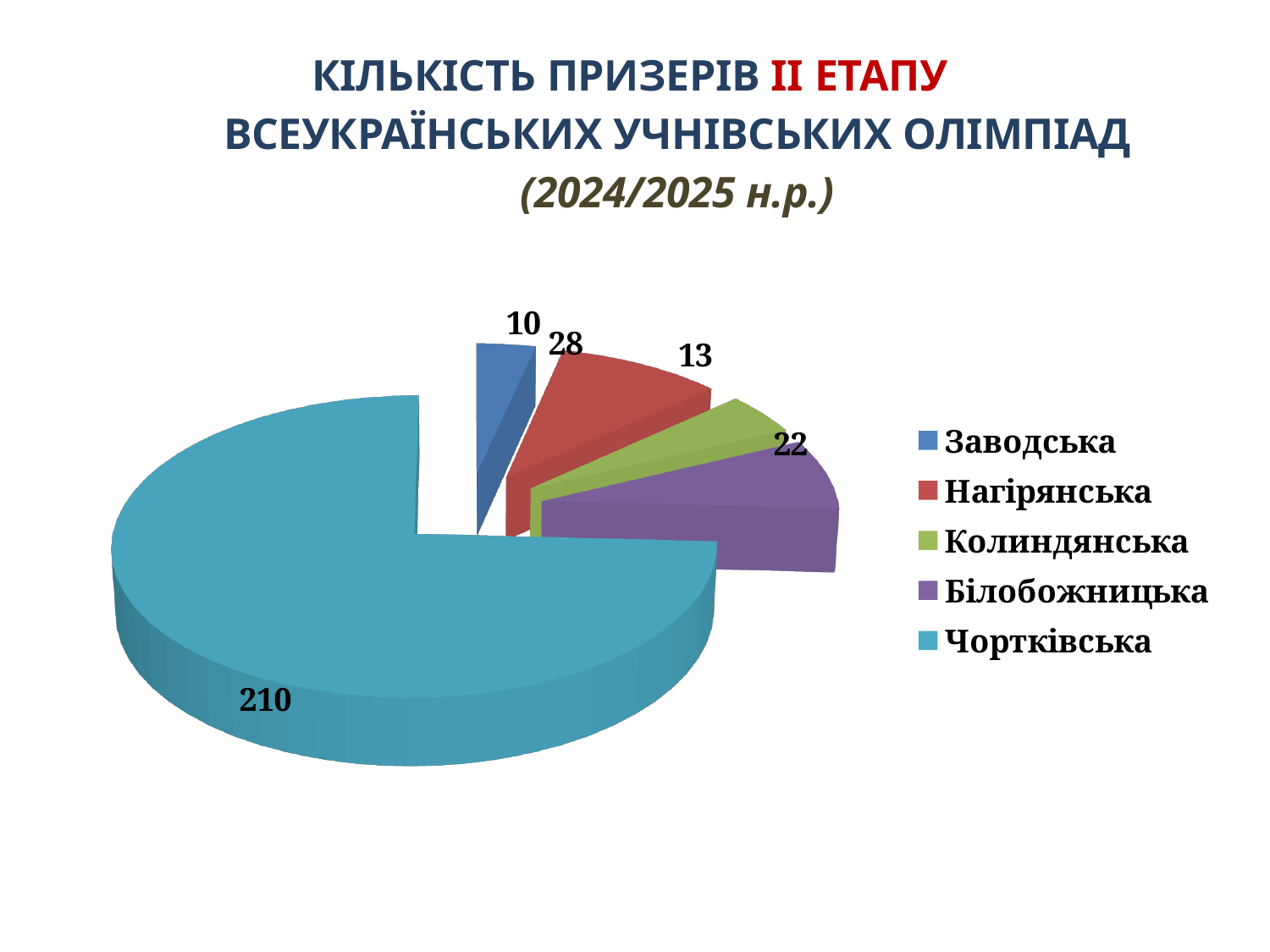
What kind of chart is shown on the slide? Pie chart How many categories does the pie chart show? 5 What is the value for Чортківська? 210 Which is larger, the value for Білобожницька or the value for Колиндянська? Білобожницька Which category has the largest slice? Чортківська What is the value for Заводська? 10 Which colour represents Білобожницька in the legend? Purple Which category has the smallest slice? Заводська What is the total of all the slices in the pie chart? 283 What is the value for Білобожницька? 22 What is the value for Нагірянська? 28 What is the difference between the values for Нагірянська and Колиндянська? 15